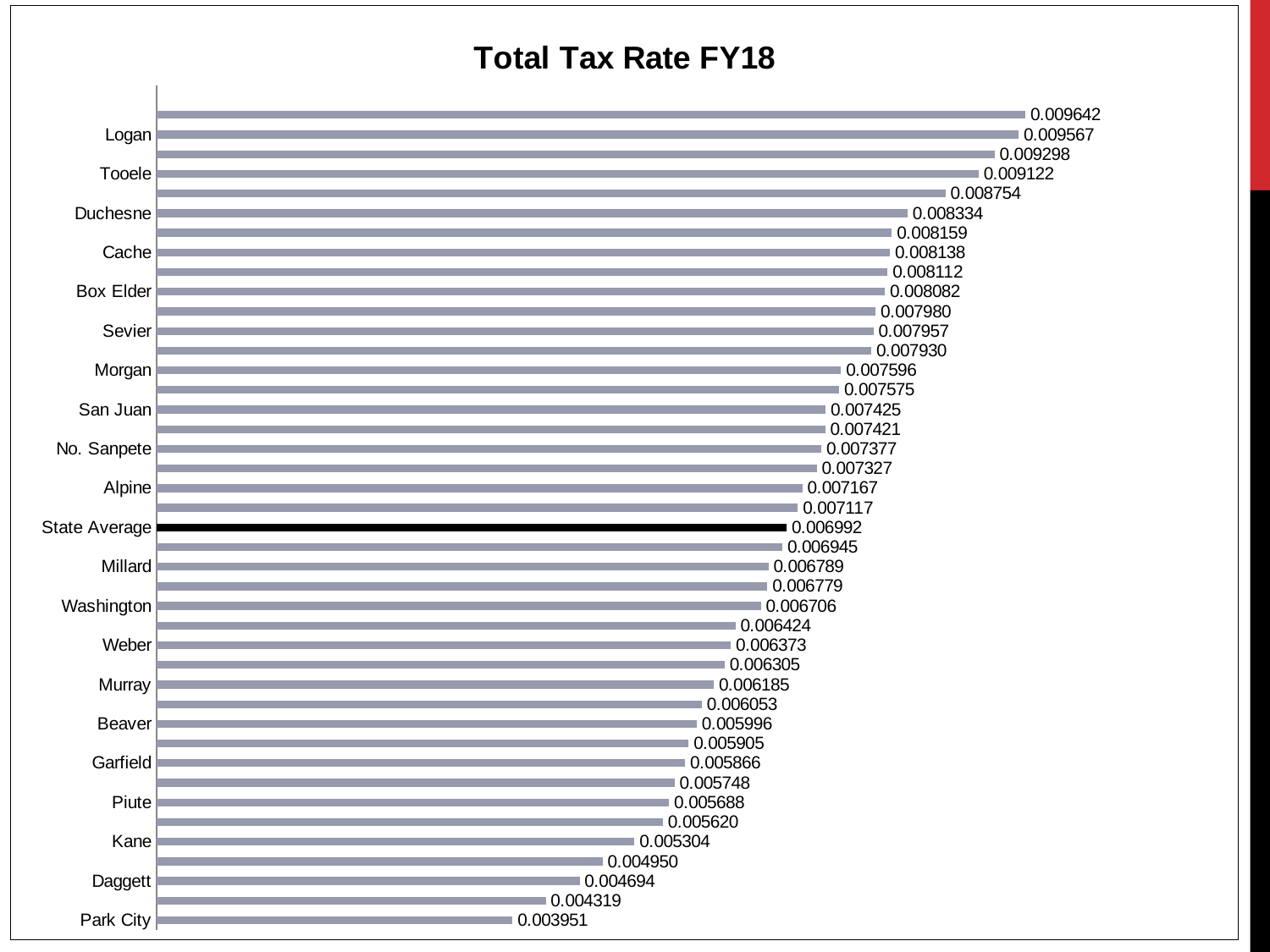
What is the total tax rate for Logan? 0.009567 What is the value shown for State Average? 0.006992 Which has a higher total tax rate, Daggett or Kane? Kane What is the highest value shown on the chart? 0.009642 Which has a higher total tax rate, Weber or Murray? Weber What is the difference between the State Average and Park City? 0.003041 What is the total tax rate for Park City? 0.003951 Which labeled category has the lowest total tax rate? Park City What is the title of the chart? Total Tax Rate FY18 What kind of chart is shown on the slide? Bar chart What is the difference between the values for Logan and Tooele? 0.000445 What is the value shown for Cache? 0.008138